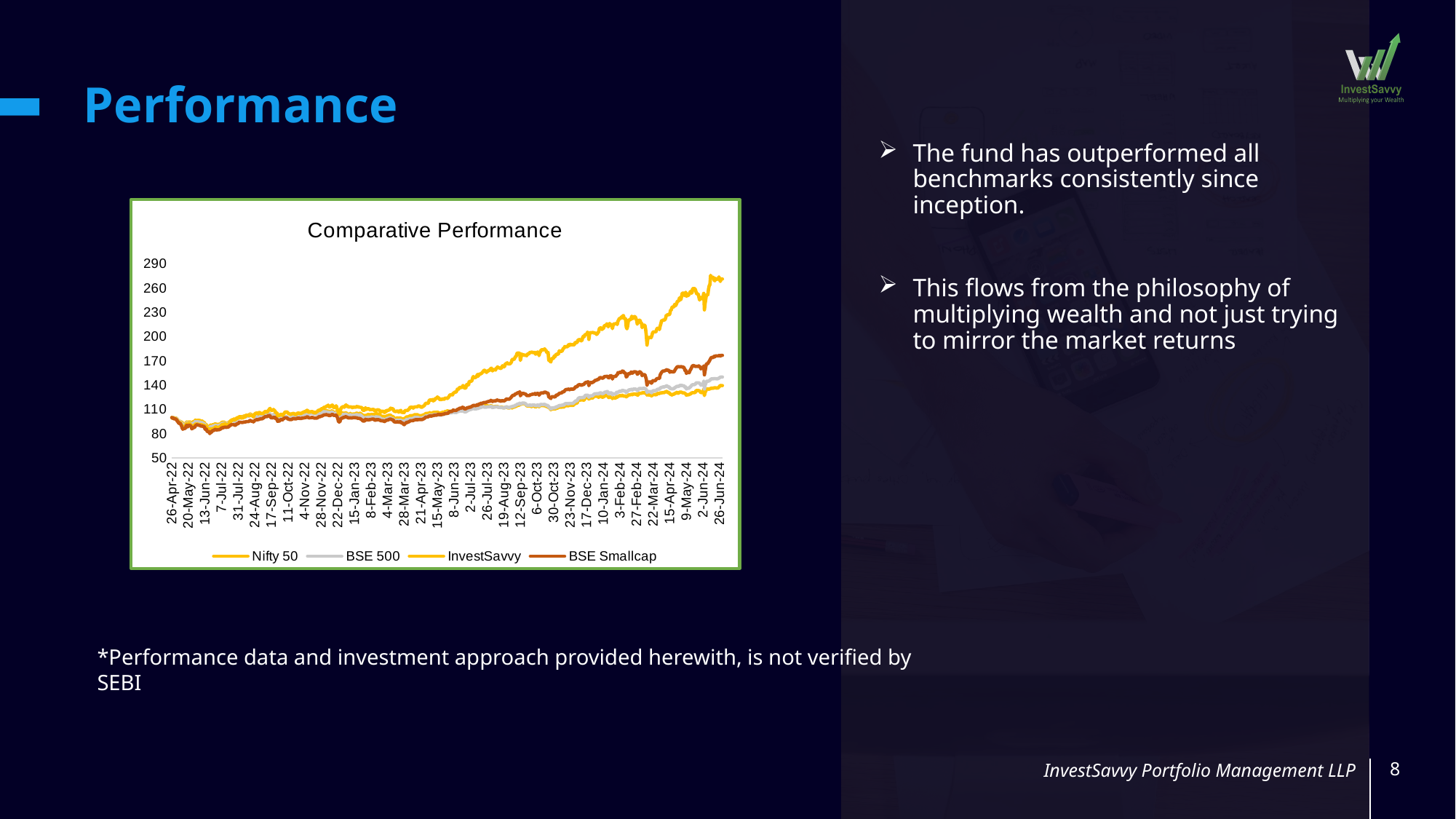
At 26-Jun-24, which is higher: BSE Smallcap or BSE 500? BSE Smallcap Is the highest value reached by any series on the chart greater or less than 260? greater How many series does the legend of the Comparative Performance chart list? 4 Is the lowest value reached by BSE Smallcap in mid-2022 greater or less than 110? less Does the BSE 500 series rise or fall overall across the chart's date range? Rise Is the value for BSE 500 at 26-Jun-24 greater or less than 170? less Does the BSE Smallcap series rise or fall overall from 26-Apr-22 to 26-Jun-24? Rise Which series are listed in the chart's legend? Nifty 50, BSE 500, InvestSavvy, BSE Smallcap What kind of chart is shown on the slide? Line chart What is the title of the chart on the slide? Comparative Performance